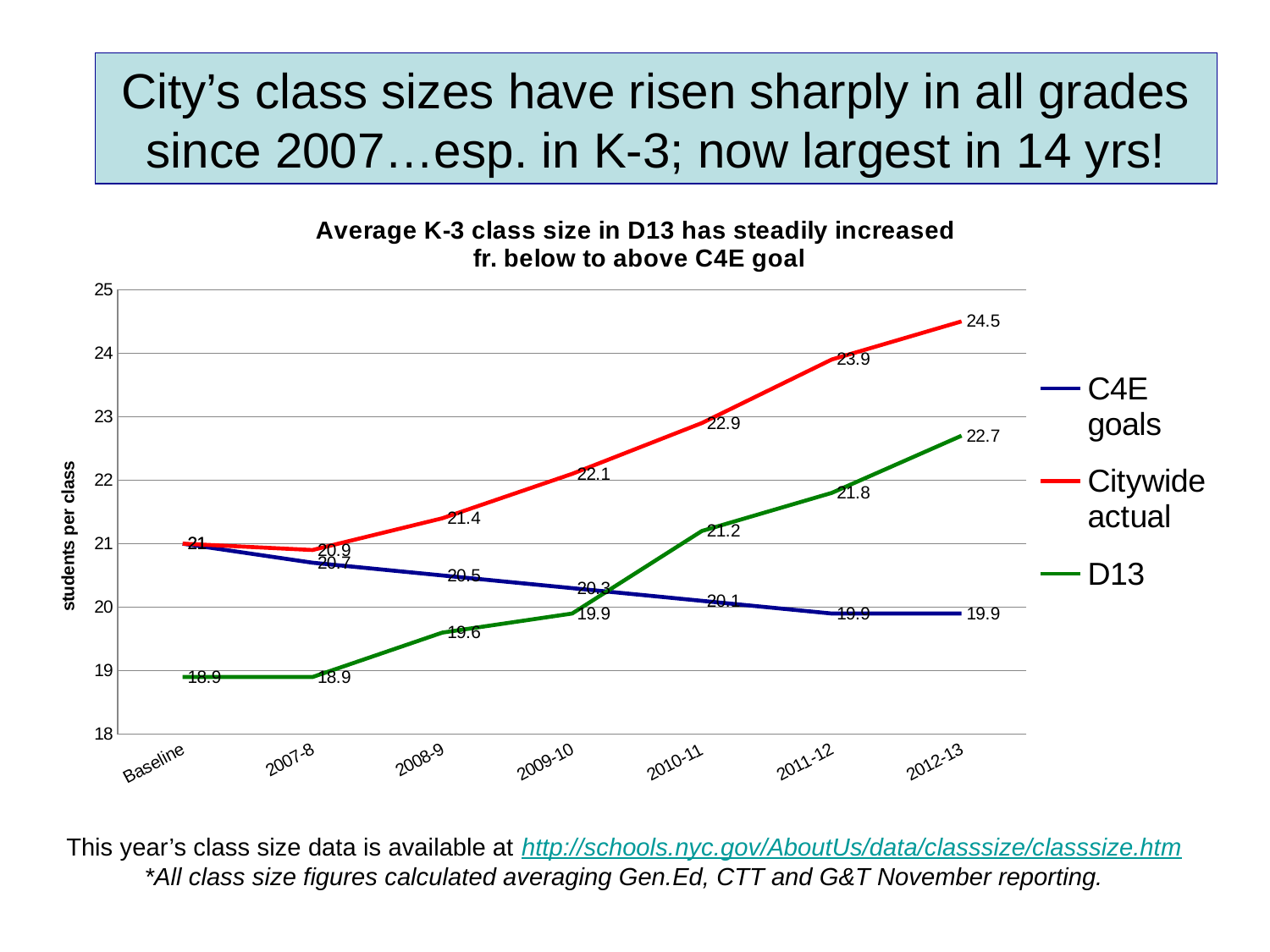
In 2010-11, which is larger: the D13 value or the C4E goals value? D13 What is the D13 value for 2012-13? 22.7 Is the Citywide actual value for 2011-12 greater or less than 23? greater What is the C4E goals value for 2012-13? 19.9 What is the difference between the Citywide actual and D13 values in 2012-13? 1.8 What kind of chart is shown on the slide? line chart Which series has the highest value in 2012-13? Citywide actual How many series does the legend list? 3 What is the D13 value for 2008-9? 19.6 What is the Citywide actual value for 2012-13? 24.5 How many points are plotted along the x axis for each series? 7 Do the C4E goals values rise or fall from Baseline to 2012-13? fall